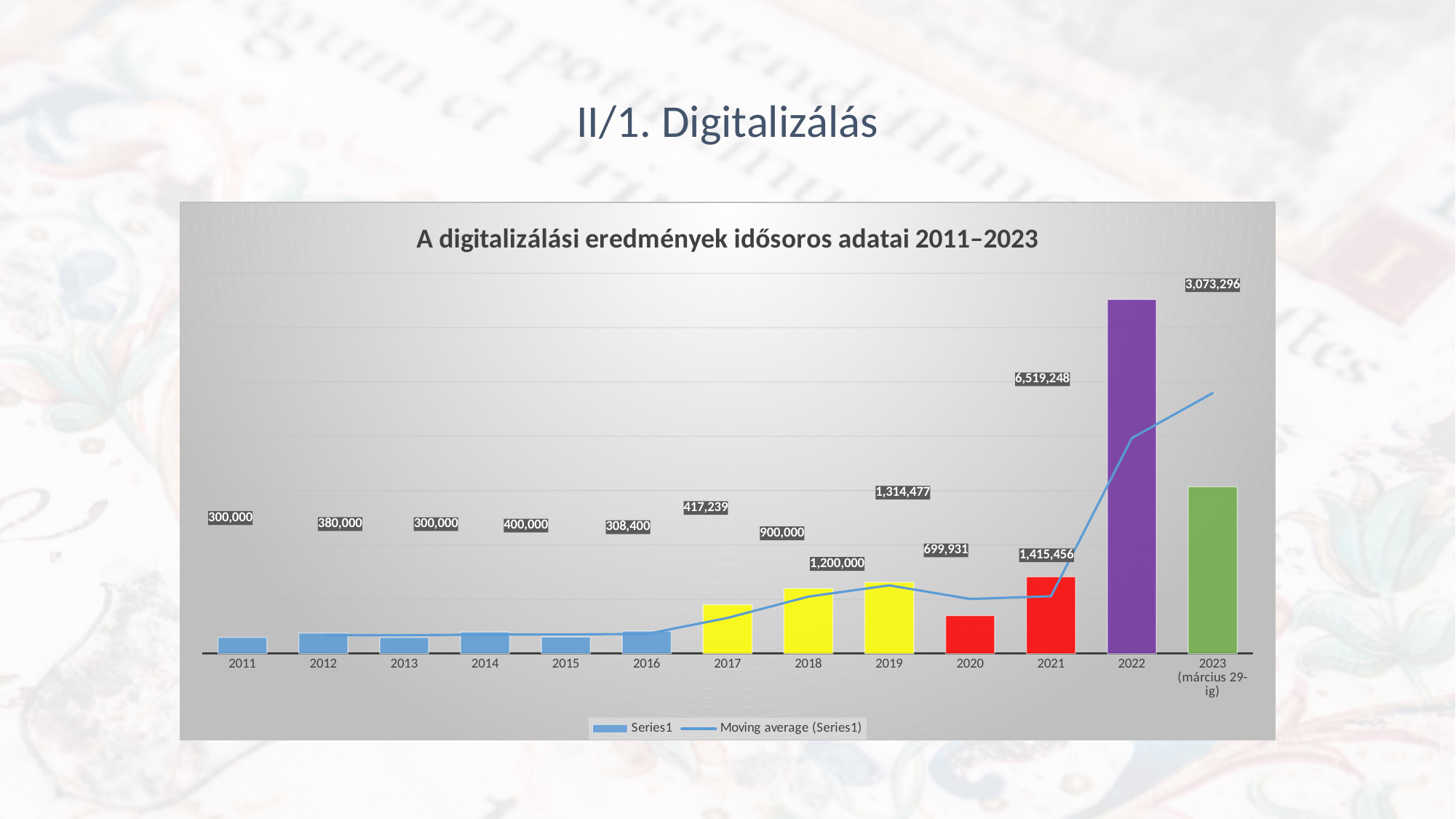
What kind of chart is this? Bar chart with a moving average line Which year has the highest value? 2022 How many entries does the legend list? 2 What is the value for 2019? 1,314,477 What is the value for 2023 (március 29-ig)? 3,073,296 What is the difference between the values for 2021 and 2020? 715,525 Which years share the lowest value of 300,000? 2011 and 2013 What is the difference between the values for 2022 and 2023 (március 29-ig)? 3,445,952 What is the title of the chart? A digitalizálási eredmények idősoros adatai 2011–2023 What is the value for 2022? 6,519,248 How many years are shown on the x axis? 13 Which is larger, the value for 2018 or the value for 2017? 2018